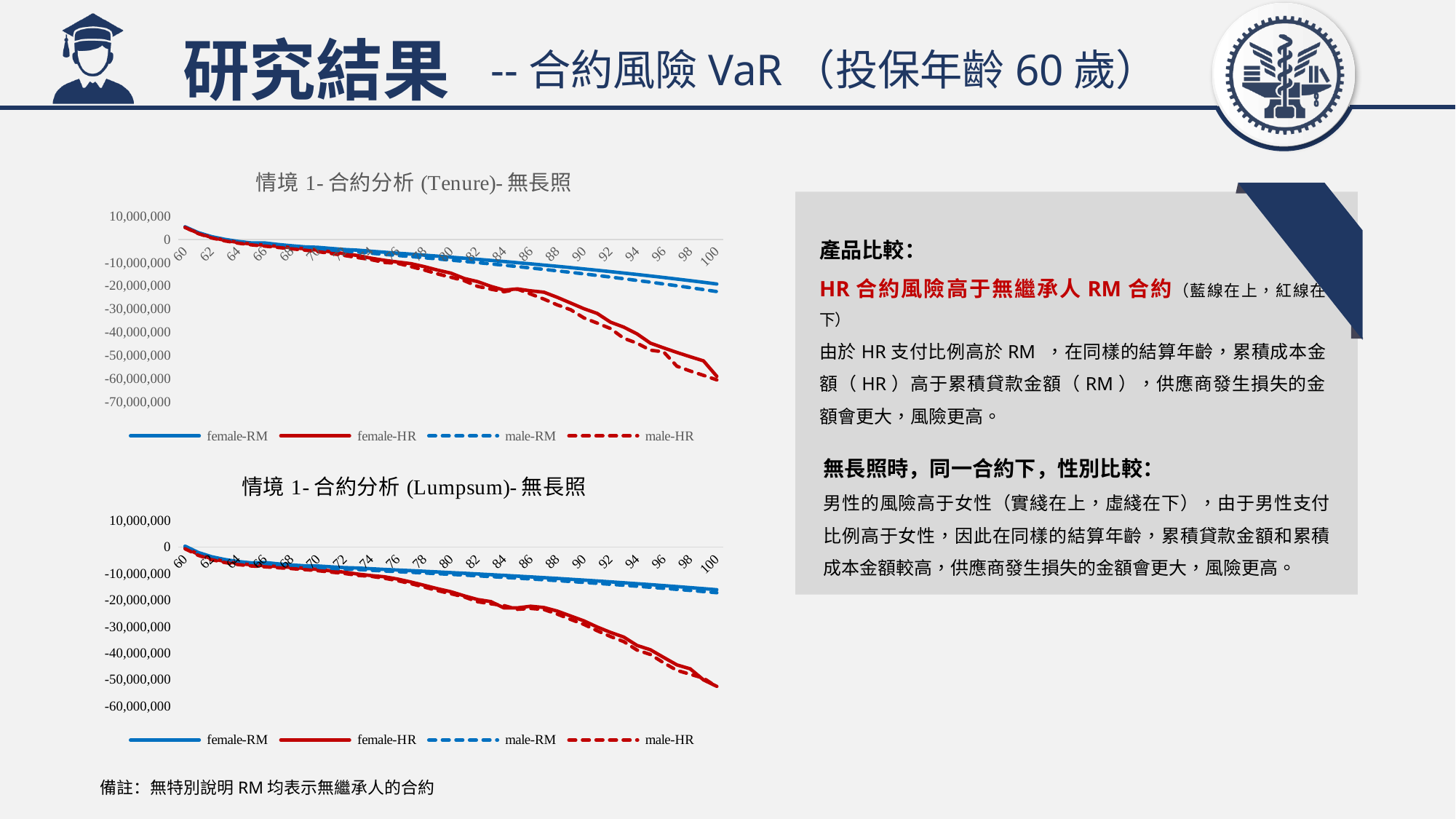
How many series does the legend of the top chart (Tenure) list? 4 In the top chart (Tenure), is the value for female-RM at age 100 greater or less than -30,000,000? greater What is the title of the bottom chart? 情境 1- 合約分析 (Lumpsum)- 無長照 In the bottom chart (Lumpsum), do the values rise or fall along the x axis? fall What type of chart is the top chart titled 情境 1- 合約分析 (Tenure)- 無長照? line chart What are the series names in the legend of the bottom chart (Lumpsum)? female-RM, female-HR, male-RM, male-HR In the top chart (Tenure), which series reaches the lowest value at age 100? male-HR In the bottom chart (Lumpsum), is the value for male-RM at age 100 greater or less than -30,000,000? greater In the top chart (Tenure), do the values rise or fall as age increases from 60 to 100? fall In the bottom chart (Lumpsum), is the value for female-HR at age 100 greater or less than -40,000,000? less In the top chart (Tenure), which is larger at age 100: female-RM or female-HR? female-RM